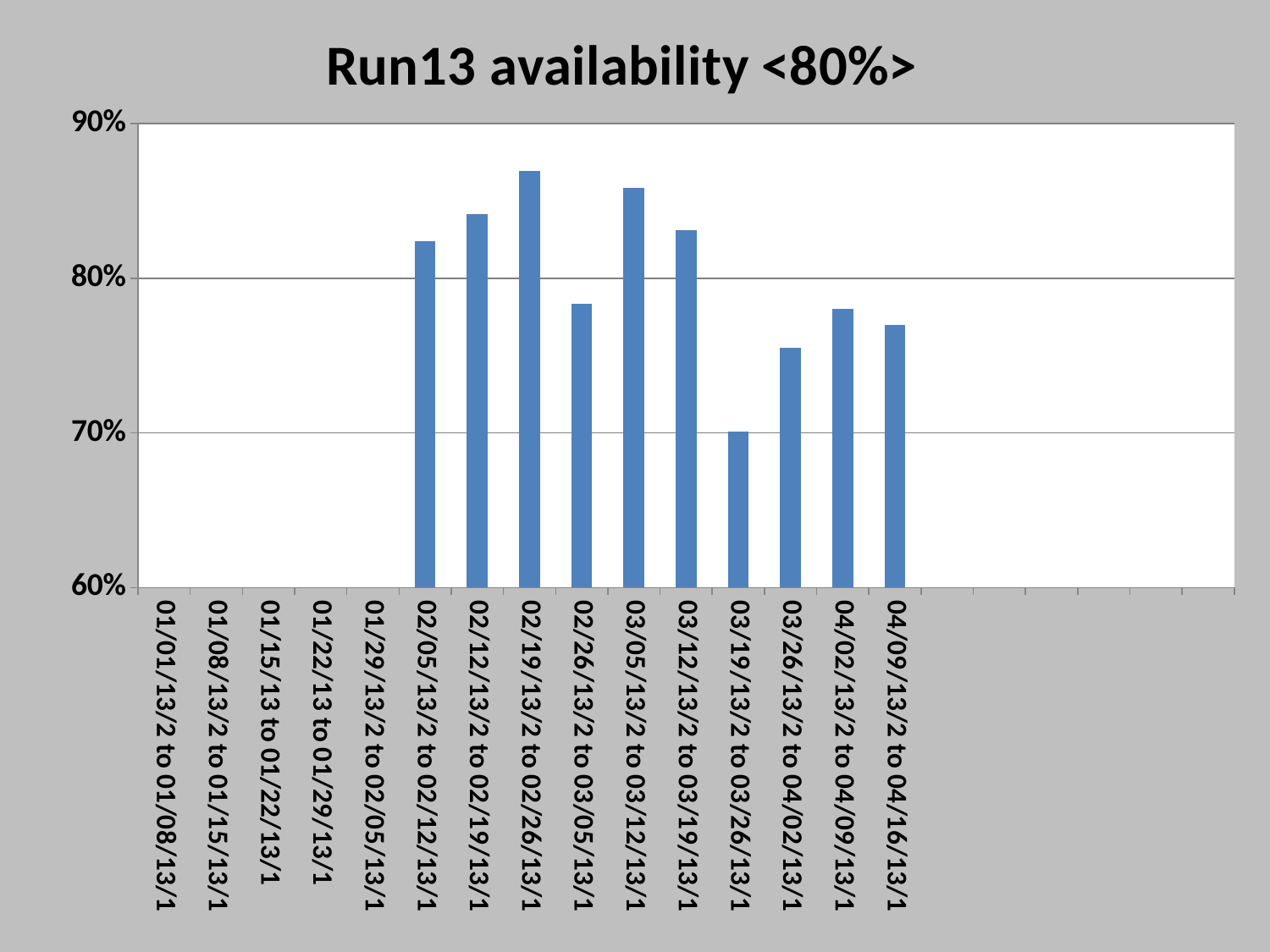
Is the value for 02/19/13/2 to 02/26/13/1 greater or less than 80%? greater Which week has the highest availability bar? 02/19/13/2 to 02/26/13/1 What kind of chart is shown on the slide? bar chart Is the value for 02/26/13/2 to 03/05/13/1 greater or less than 80%? less How many weeks have a bar plotted on the chart? 10 What is the title of the chart? Run13 availability <80%> Which week has the lowest availability bar among the weeks with a plotted bar? 03/19/13/2 to 03/26/13/1 Which is larger, the value for 02/12/13/2 to 02/19/13/1 or the value for 02/26/13/2 to 03/05/13/1? 02/12/13/2 to 02/19/13/1 Which is larger, the value for 03/05/13/2 to 03/12/13/1 or the value for 03/12/13/2 to 03/19/13/1? 03/05/13/2 to 03/12/13/1 Is the value for 03/26/13/2 to 04/02/13/1 greater or less than 80%? less From 03/19/13/2 to 03/26/13/1 through 04/02/13/2 to 04/09/13/1, do the values rise or fall? rise